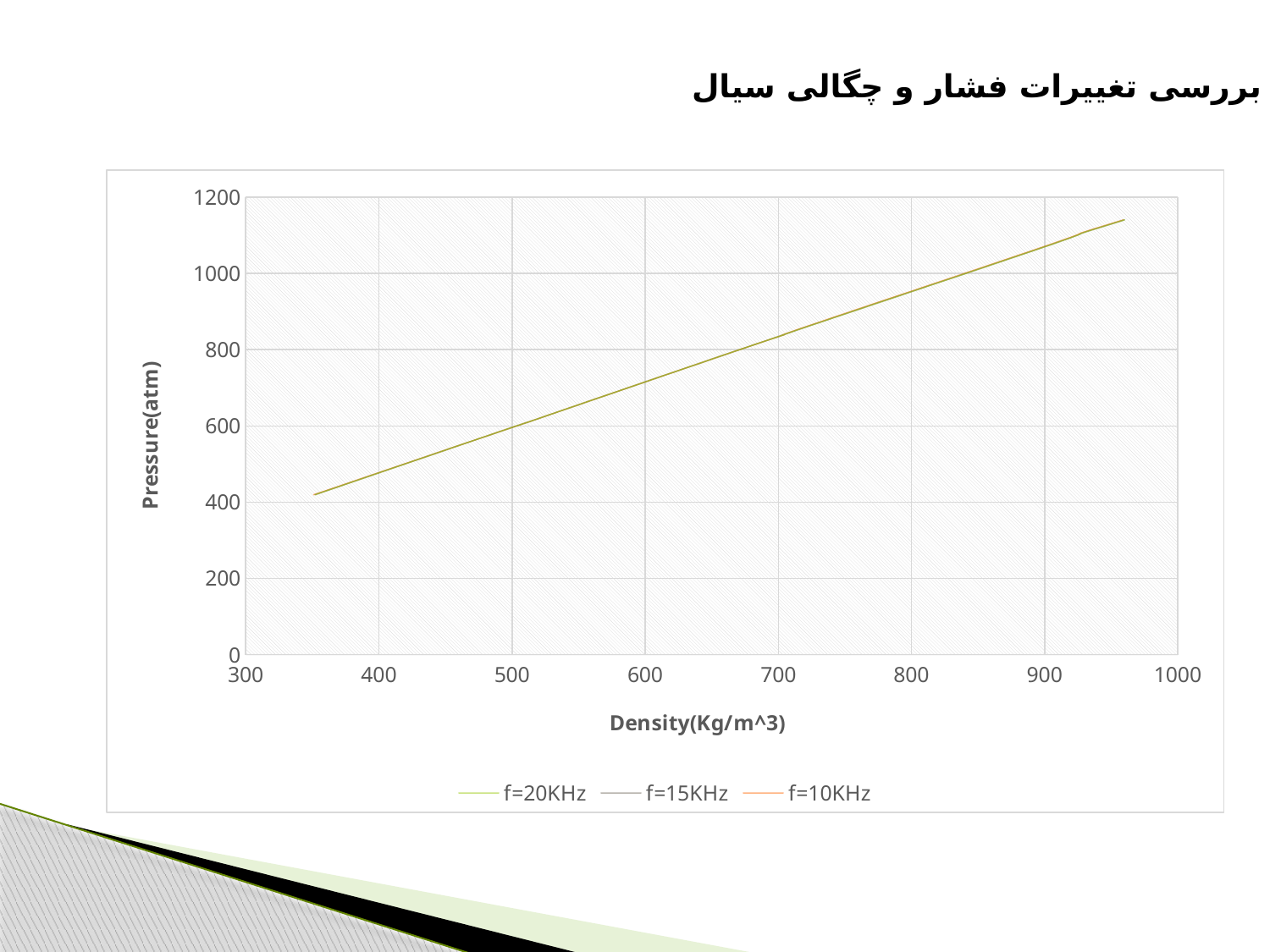
Is the pressure value at a density of 800 Kg/m^3 greater or less than 1000 atm? less What is the label of the y axis? Pressure(atm) What is the label of the x axis? Density(Kg/m^3) How many series does the legend list? 3 Is the pressure value at a density of 400 Kg/m^3 greater or less than 600 atm? less Is the pressure value at a density of 600 Kg/m^3 greater or less than 800 atm? less Do the pressure values rise or fall as density increases along the x axis? rise What kind of chart is shown on the slide? line chart